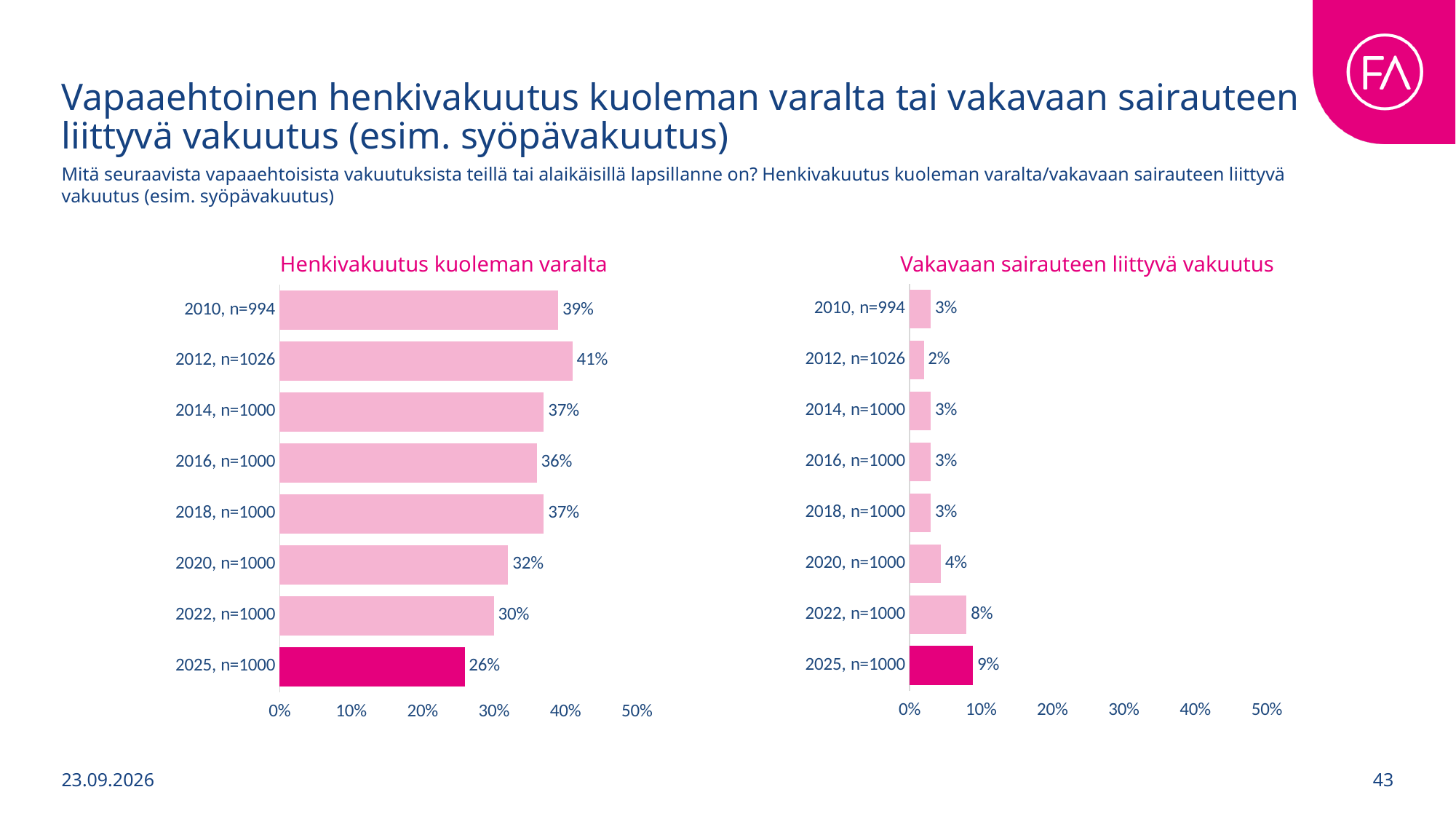
In the 'Henkivakuutus kuoleman varalta' chart, what is the value for 2025, n=1000? 26% In the 'Vakavaan sairauteen liittyvä vakuutus' chart, which category has the lowest value? 2012, n=1026 In the 'Henkivakuutus kuoleman varalta' chart, which category has the lowest value? 2025, n=1000 What type of chart is the 'Henkivakuutus kuoleman varalta' chart? bar chart In the 'Vakavaan sairauteen liittyvä vakuutus' chart, which category has the highest value? 2025, n=1000 In the 'Henkivakuutus kuoleman varalta' chart, do the values generally rise or fall from 2012 to 2025? fall In the 'Henkivakuutus kuoleman varalta' chart, what is the difference between the values for 2010, n=994 and 2025, n=1000? 13% In the 'Henkivakuutus kuoleman varalta' chart, how many categories are shown? 8 In the 'Vakavaan sairauteen liittyvä vakuutus' chart, is the value for 2025, n=1000 greater or less than 10%? less In the 'Vakavaan sairauteen liittyvä vakuutus' chart, which is larger, the value for 2020, n=1000 or 2025, n=1000? 2025, n=1000 In the 'Vakavaan sairauteen liittyvä vakuutus' chart, what is the value for 2022, n=1000? 8% In the 'Henkivakuutus kuoleman varalta' chart, which category has the highest value? 2012, n=1026